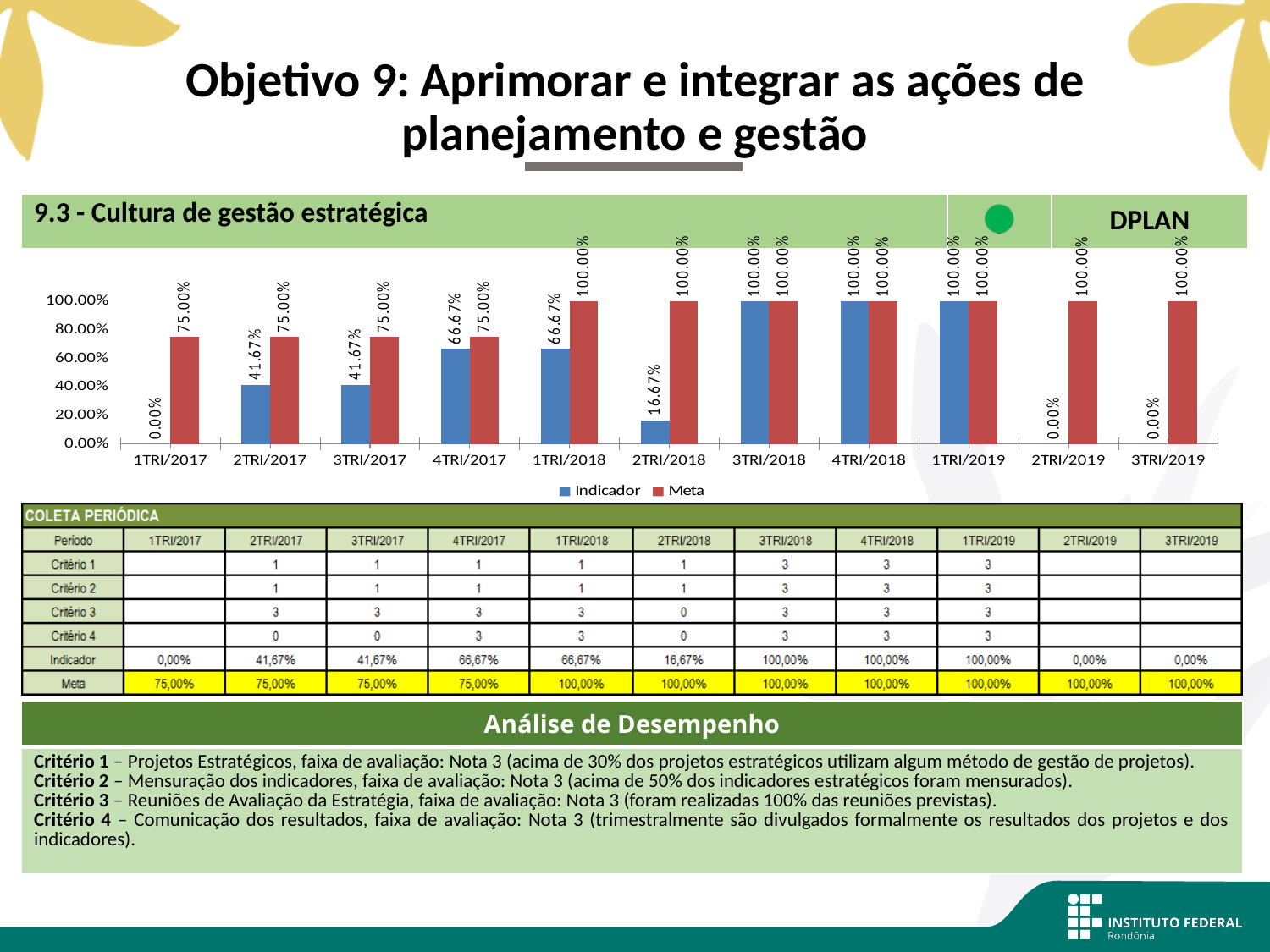
What is the Meta value for 1TRI/2018? 100.00% How many series does the chart legend list? 2 How many periods (categories) are shown on the x axis of the chart? 11 What kind of chart is shown on the slide? Bar chart What is the difference between the Meta and the Indicador for 2TRI/2017? 33.33% What is the difference between the Meta and the Indicador for 2TRI/2018? 83.33% What is the Indicador value for 4TRI/2017? 66.67% What is the Meta value for 3TRI/2017? 75.00% Which series is shown in blue in the chart legend? Indicador Which is larger for 1TRI/2018, the Indicador or the Meta? Meta What is the Indicador value for 2TRI/2018? 16.67% Does the Indicador value rise or fall from 1TRI/2019 to 2TRI/2019? Fall